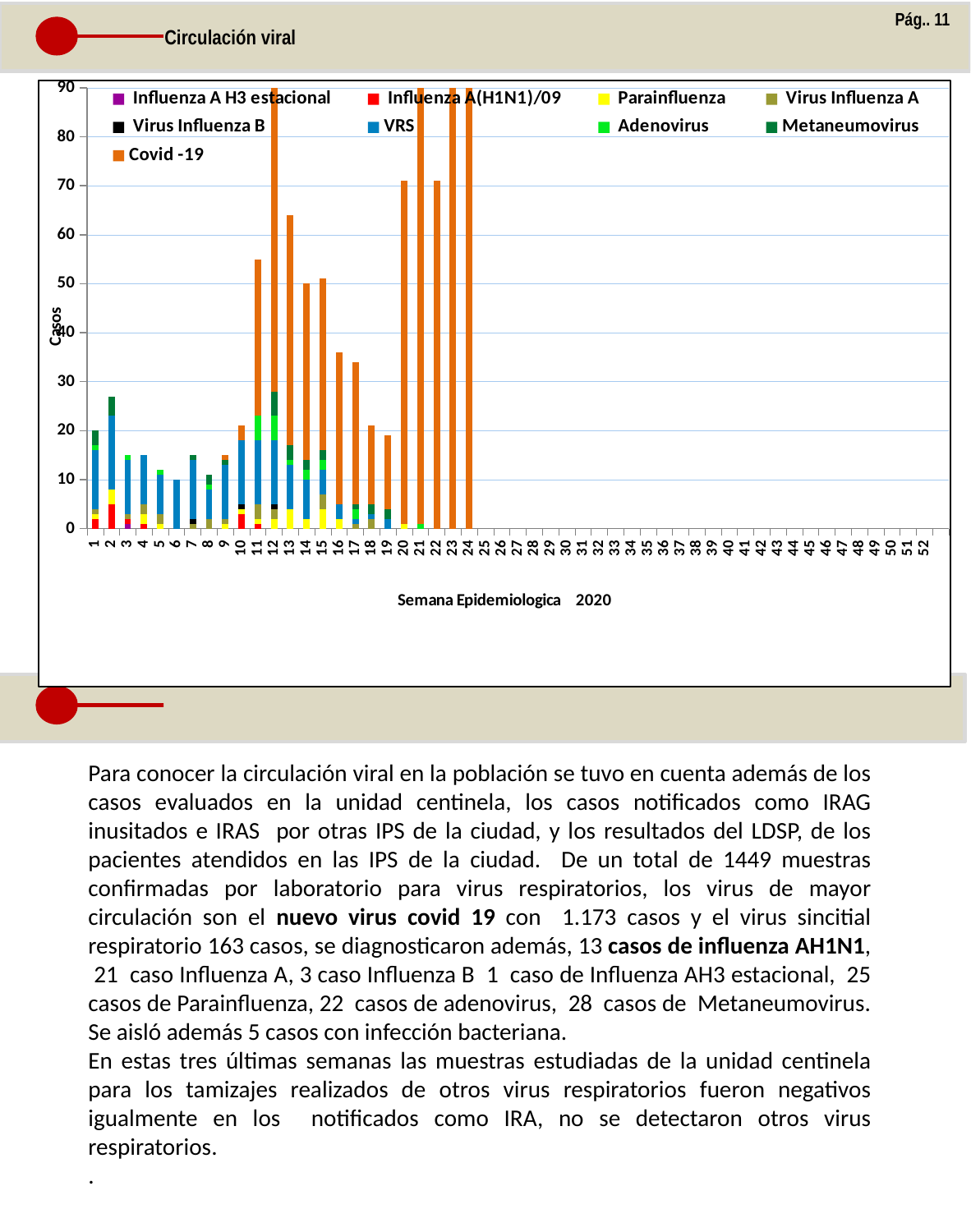
Is the total bar for week 2 greater or less than 30? less What kind of chart is shown on the slide? Stacked bar chart From week 16 to week 19, do the total bars rise or fall? Fall Up to which epidemiological week do the bars show cases before the bars stop? 24 What is the title of the x axis? Semana Epidemiologica 2020 Is the total bar for week 21 greater or less than 80? greater Which week has the taller total bar, week 19 or week 21? Week 21 How many series does the chart legend list? 9 Is the total bar for week 16 greater or less than 40? less How many epidemiological weeks are labelled on the x axis? 52 Which week has the taller total bar, week 12 or week 13? Week 12